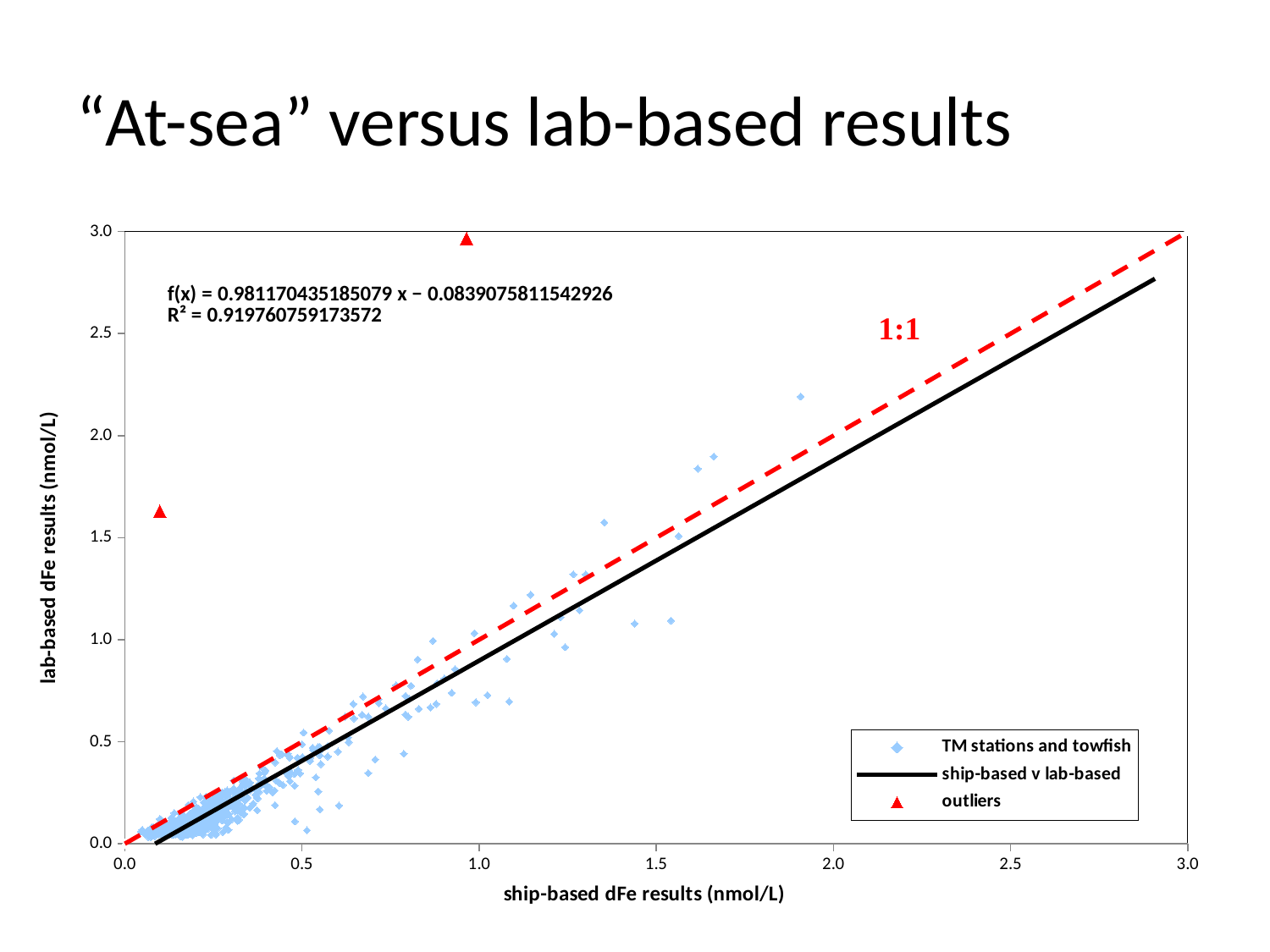
What is the intercept of the fitted line f(x) printed on the chart? −0.0839075811542926 Is the lab-based value of the outlier plotted near a ship-based value of 1.0 greater or less than 2.5? greater What kind of chart is shown on the slide? scatter chart What is the label of the x axis? ship-based dFe results (nmol/L) What is the R² value printed on the chart? 0.919760759173572 What is the slope of the fitted line f(x) printed on the chart? 0.981170435185079 How many points are plotted in the 'outliers' series? 2 Do the lab-based dFe values generally rise or fall as the ship-based dFe values increase? rise Is the lab-based value of the outlier plotted near a ship-based value of 0.1 greater or less than 1.5? greater What is the title of the slide containing the chart? "At-sea" versus lab-based results What is the maximum value shown on the y axis? 3.0 How many series does the legend list? 3